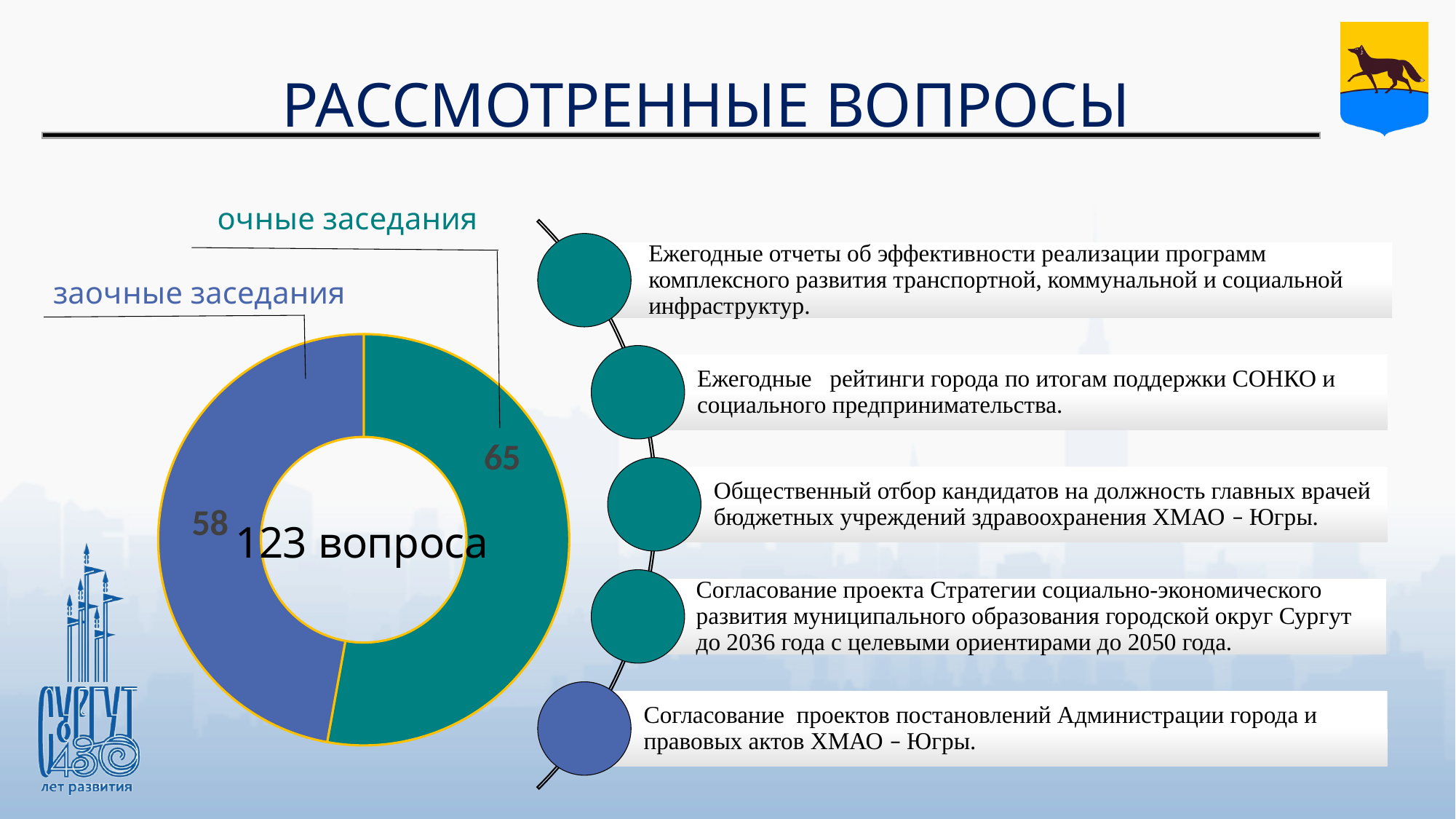
Which category has the larger value in the donut chart? очные заседания Is the value for очные заседания larger or smaller than the value for заочные заседания? larger Which category has the smaller value in the donut chart? заочные заседания What is the total of the two segments in the donut chart? 123 What kind of chart is shown on the slide? donut chart What value is shown for заочные заседания in the donut chart? 58 What value is shown for очные заседания in the donut chart? 65 What is the difference between the values for очные заседания and заочные заседания? 7 What colour is the segment for заочные заседания? blue What text is printed in the centre of the donut chart? 123 вопроса How many categories does the donut chart show? 2 What share of the total do очные заседания represent (65 of 123)? 52.8%